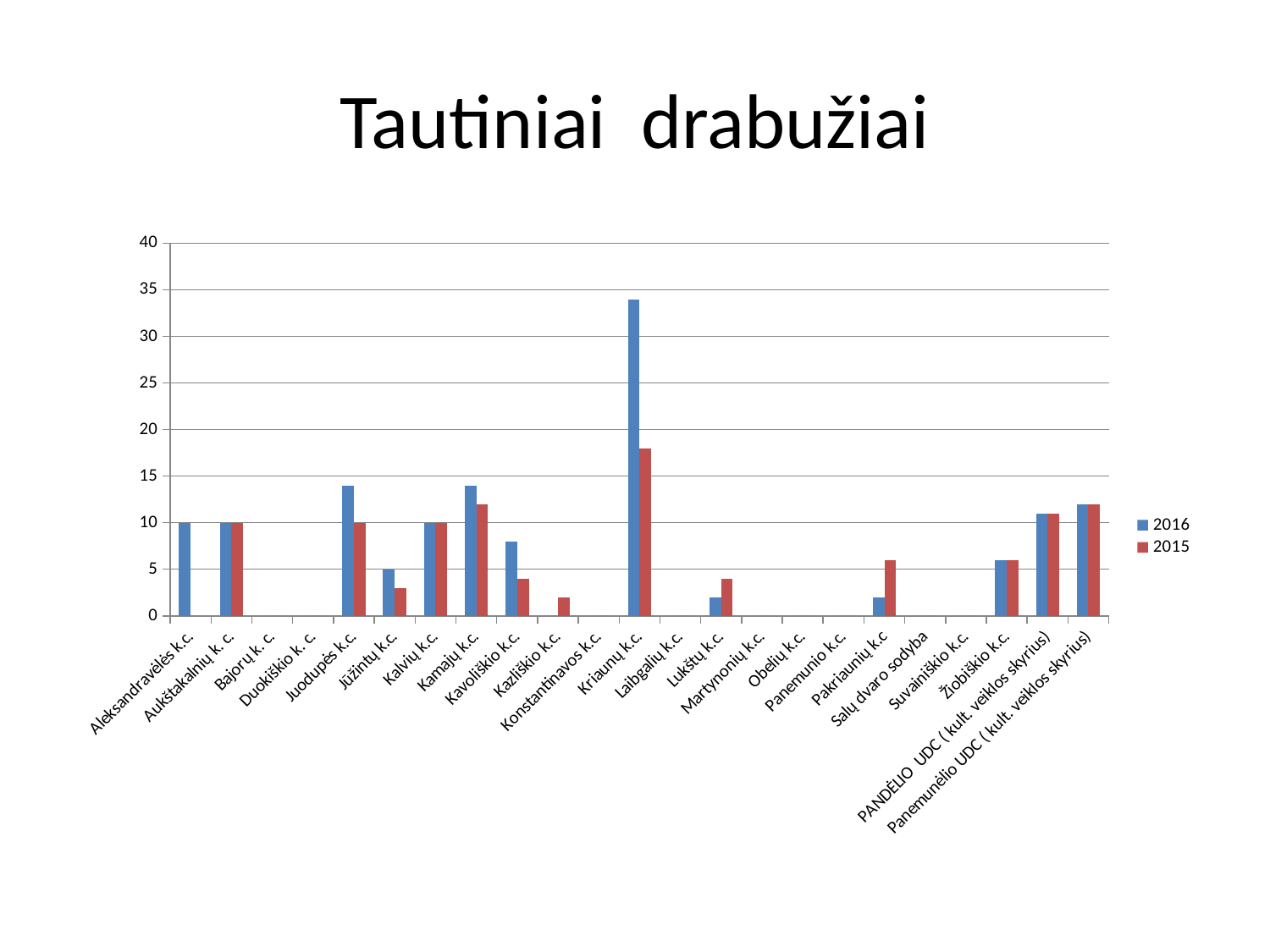
What is the value for Aukštakalnių k. c. in 2015? 10 What is the title of the slide? Tautiniai drabužiai Is the 2016 value for Kriaunų k.c. greater or less than 30? greater How many series does the legend list? 2 For Kriaunų k.c., which series has the larger value, 2016 or 2015? 2016 What kind of chart is shown on the slide? bar chart For Pakriaunių k.c, which series has the larger value, 2016 or 2015? 2015 Is the 2016 value for Juodupės k.c. greater or less than 10? greater Which category has the highest value for 2016? Kriaunų k.c. What is the value for Kalvių k.c. in 2016? 10 How many categories are shown on the x axis? 23 Is the 2015 value for Kriaunų k.c. greater or less than 20? less